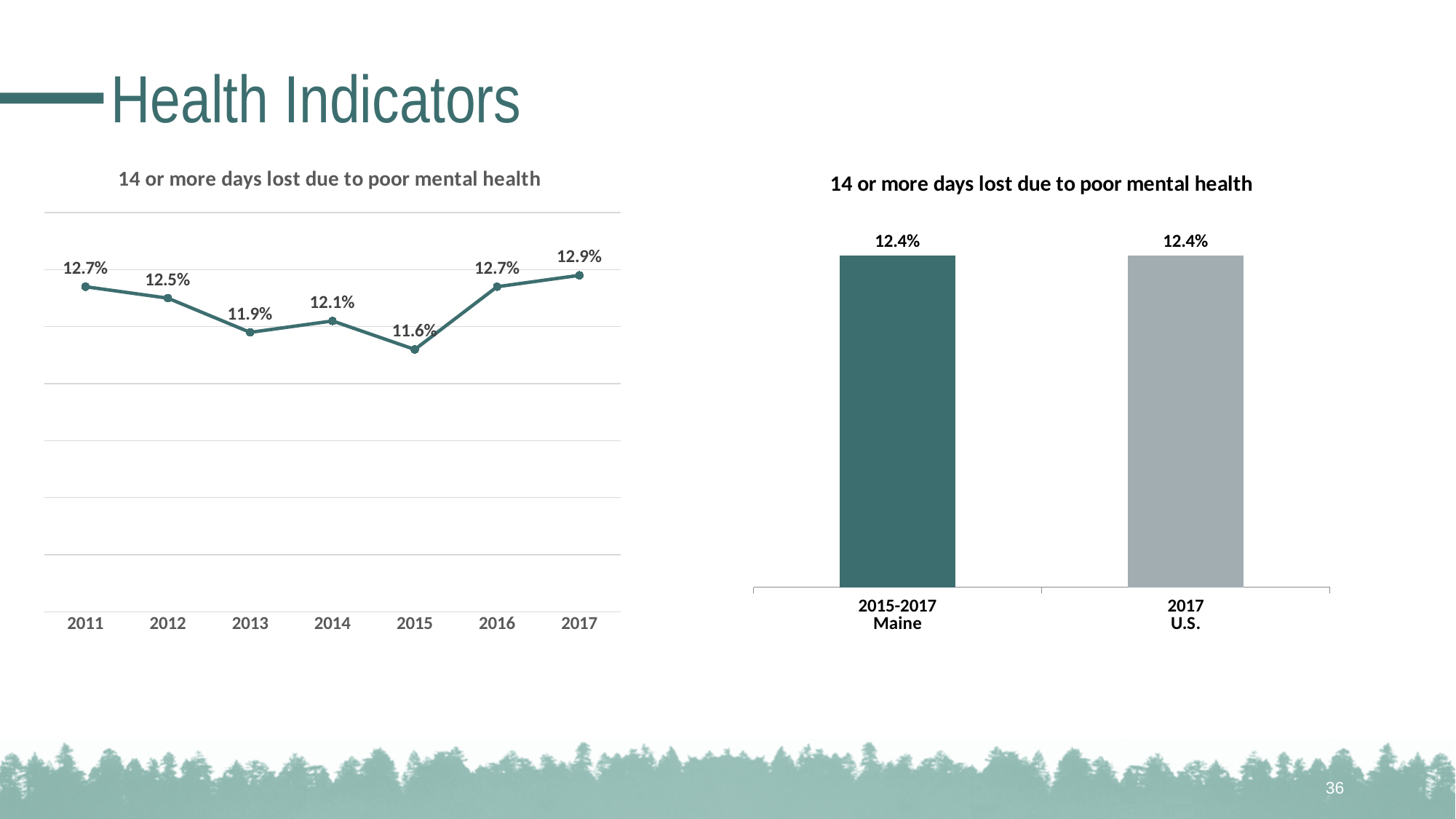
What kind of chart is the chart on the left? line chart In the line chart on the left, what is the value for 2011? 12.7% In the bar chart on the right, what is the value for 2017 U.S.? 12.4% In the line chart on the left, what is the value for 2015? 11.6% In the line chart on the left, what is the difference between the 2017 value and the 2015 value? 1.3% In the line chart on the left, which year has the lowest value? 2015 In the line chart on the left, do the values rise or fall from 2015 to 2017? rise In the bar chart on the right, what is the value for 2015-2017 Maine? 12.4% In the line chart on the left, which is larger, the value for 2013 or the value for 2014? 2014 In the line chart on the left, how many years are plotted? 7 In the line chart on the left, which year has the highest value? 2017 What kind of chart is the chart on the right? bar chart